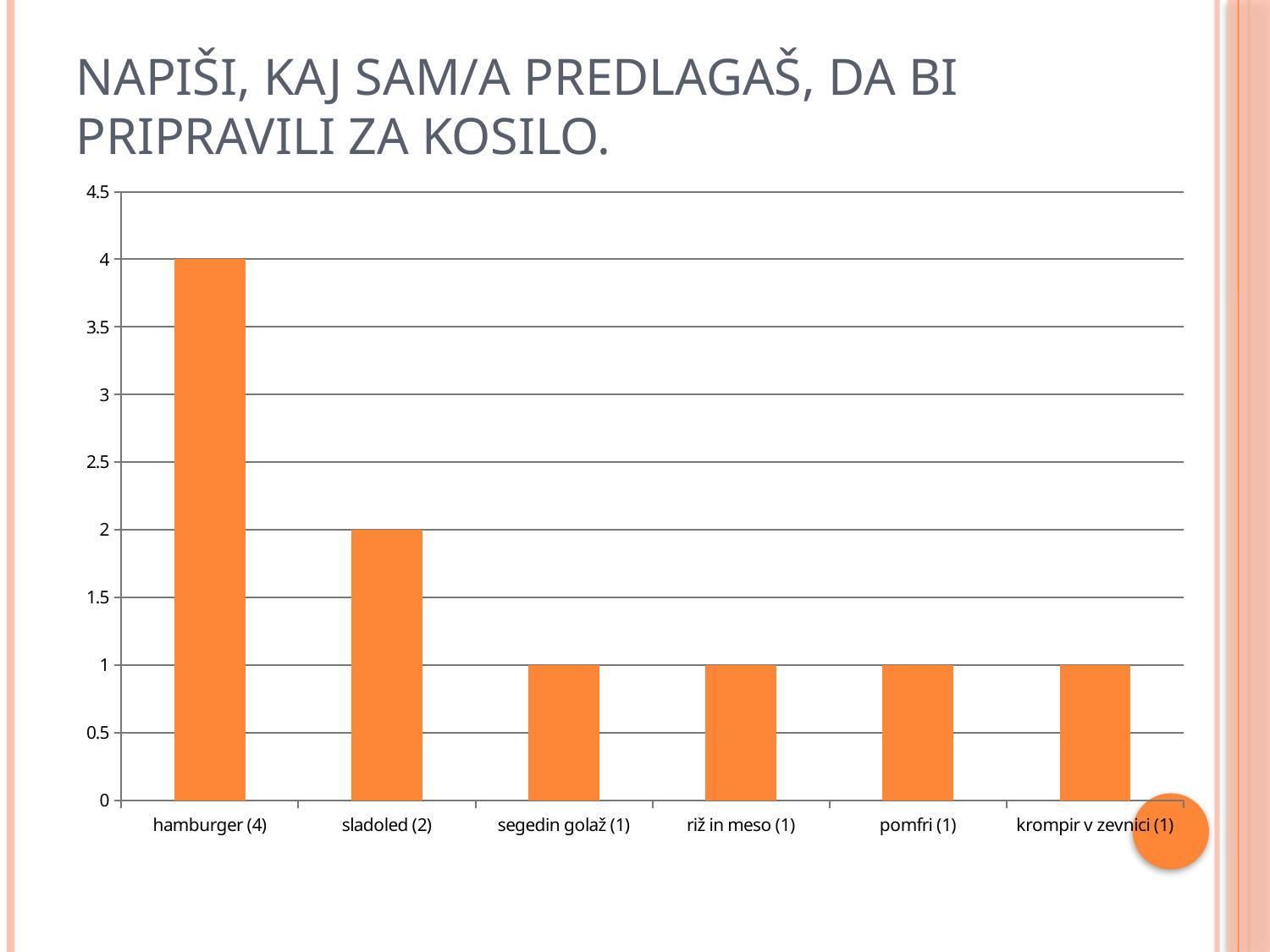
What is the value for hamburger (4)? 4 What kind of chart is shown on the slide? bar chart What is the difference between the values for hamburger (4) and sladoled (2)? 2 What is the value for pomfri (1)? 1 Is the value for segedin golaž (1) greater or less than 2? less Is the value for hamburger (4) greater or less than 3? greater Which is larger, the value for hamburger (4) or the value for sladoled (2)? hamburger (4) Which category has the highest value? hamburger (4) How many categories are shown on the x axis? 6 What is the value for sladoled (2)? 2 What colour are the bars in the chart? orange What is the difference between the values for sladoled (2) and riž in meso (1)? 1